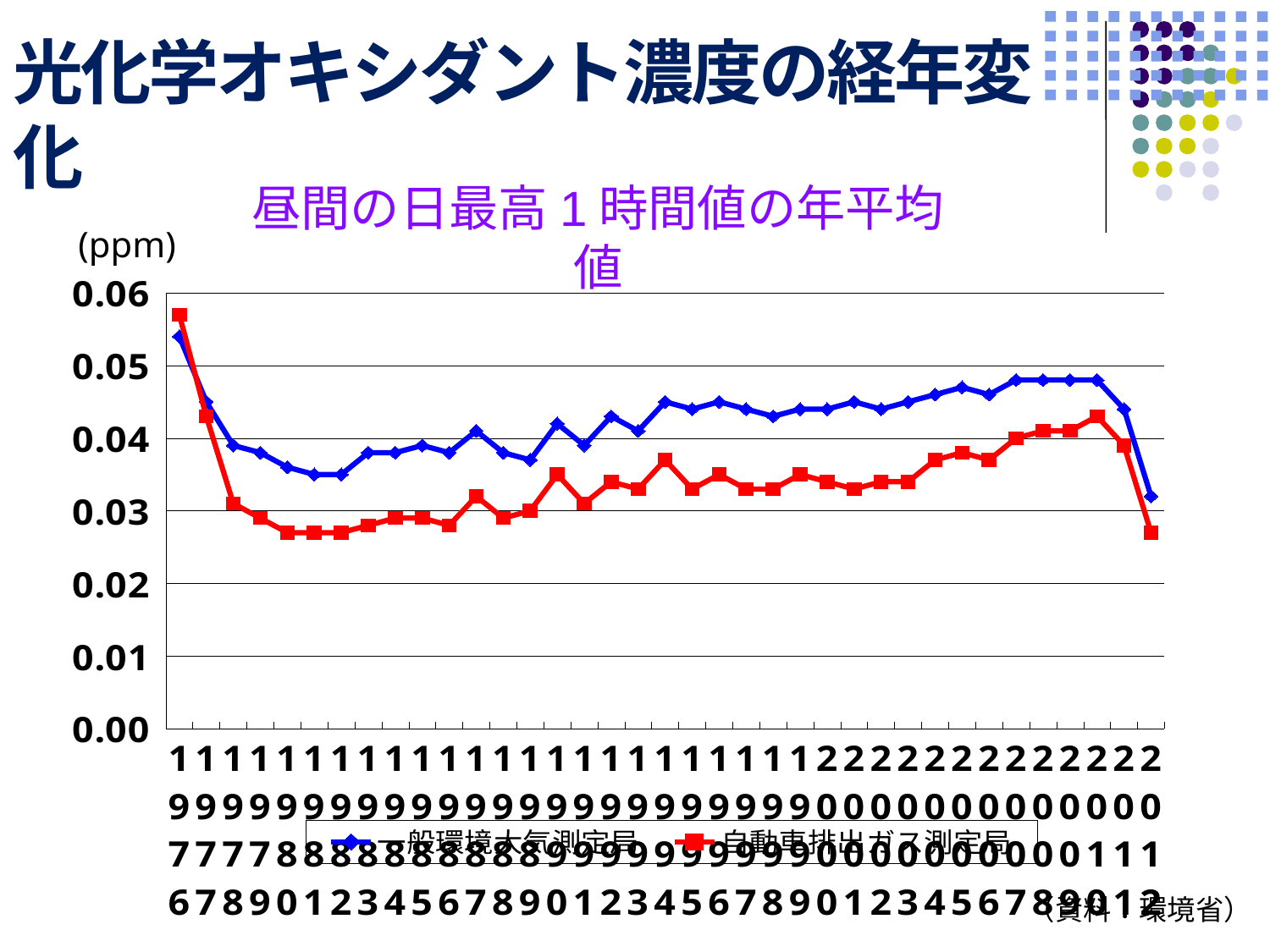
Do the values for both series rise or fall from 1976 to 1980? fall Is the value for 自動車排出ガス測定局 in 2012 greater or less than 0.03? less What kind of chart is shown on the slide? line chart How many series does the legend list? 2 In 2000, which series has the larger value, 一般環境大気測定局 or 自動車排出ガス測定局? 一般環境大気測定局 What is the unit shown for the y axis? ppm Is the value for 一般環境大気測定局 in 2010 greater or less than 0.05? less Is the value for 一般環境大気測定局 in 2012 greater or less than 0.03? greater How many years (data points) are plotted along the x axis? 37 What is the subtitle of the chart (in purple)? 昼間の日最高１時間値の年平均値 In which year is the 自動車排出ガス測定局 series at its highest? 1976